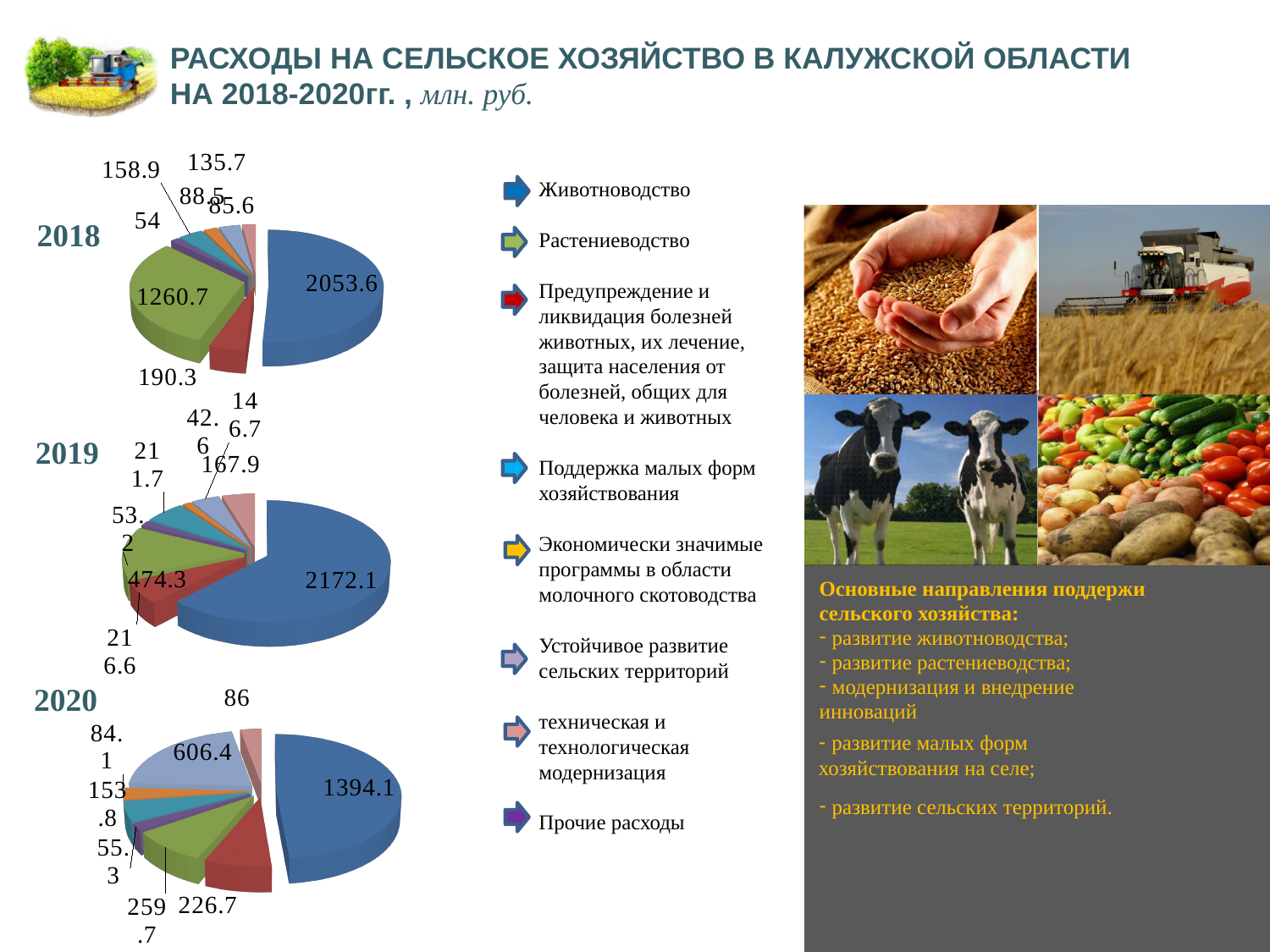
What kind of charts are shown on the slide? Pie charts What is the difference between the Животноводство value in 2019 (2172.1) and in 2018 (2053.6)? 118.5 Is the value for Животноводство larger in the 2018 chart or the 2019 chart? 2019 In the 2020 pie chart, what is the value of the largest slice (Животноводство)? 1394.1 How many pie charts are on the slide? 3 In the 2018 pie chart, what is the value for Растениеводство (the green slice)? 1260.7 In the 2018 pie chart, what is the difference between Животноводство (2053.6) and Растениеводство (1260.7)? 792.9 In the 2019 pie chart, what is the value for Растениеводство (the green slice)? 474.3 Which category has the largest slice in the 2020 pie chart? Животноводство How many categories does the legend list? 8 In the 2019 pie chart, what is the value of the largest slice (Животноводство)? 2172.1 In the 2018 pie chart, what is the value of the largest slice (Животноводство)? 2053.6